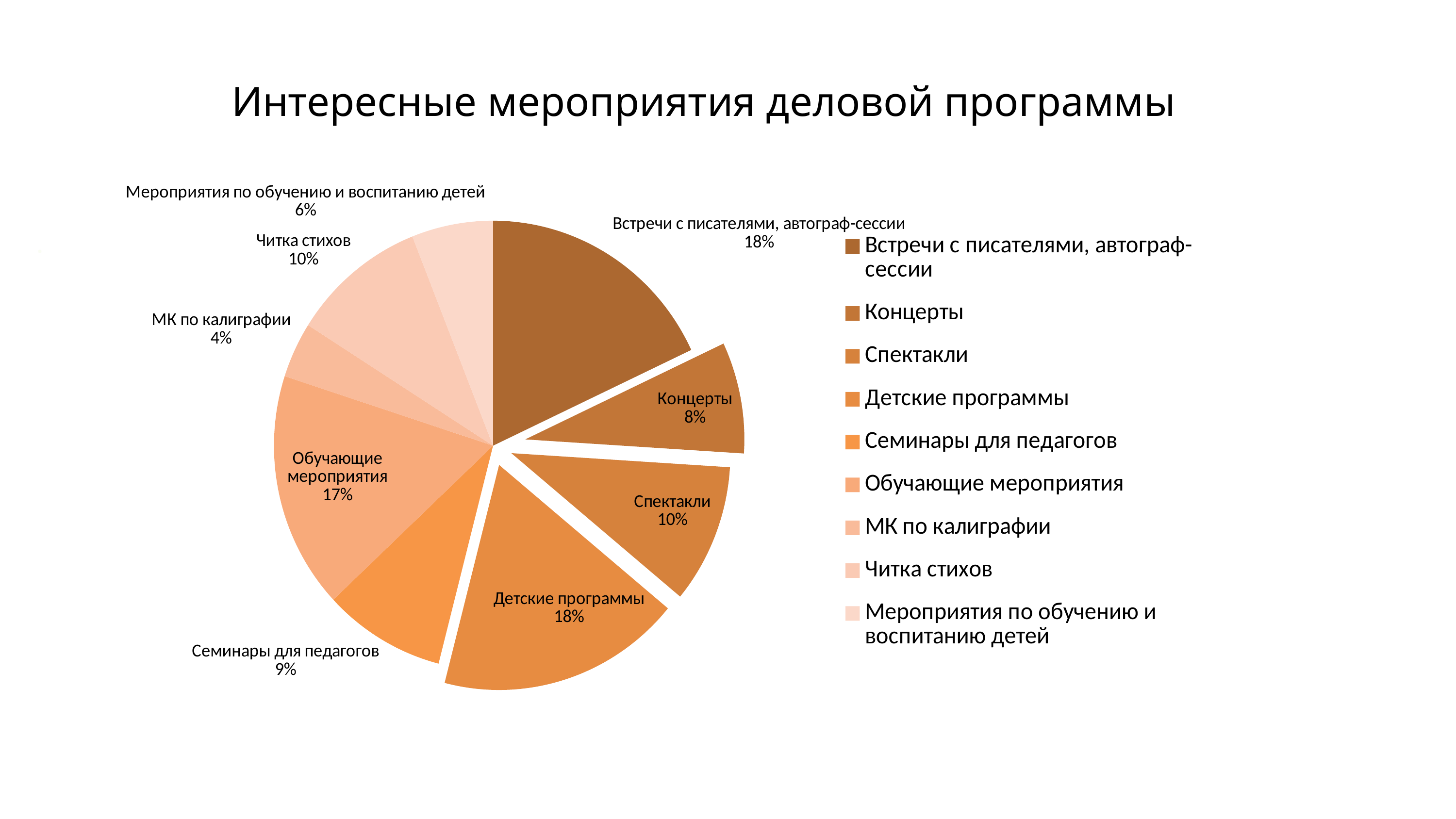
What kind of chart is shown on the slide? pie chart Which is larger: Обучающие мероприятия or Концерты? Обучающие мероприятия What is the title of the chart? Интересные мероприятия деловой программы What share of the pie does Мероприятия по обучению и воспитанию детей have? 6% What share of the pie does Обучающие мероприятия have? 17% What is the difference in percentage points between Встречи с писателями, автограф-сессии and Концерты? 10 How many entries does the legend list? 9 How many categories are shown in the pie chart? 9 Which category has the smallest slice of the pie? МК по калиграфии What share of the pie does Семинары для педагогов have? 9% What share of the pie does Детские программы have? 18% What share of the pie does Концерты have? 8%